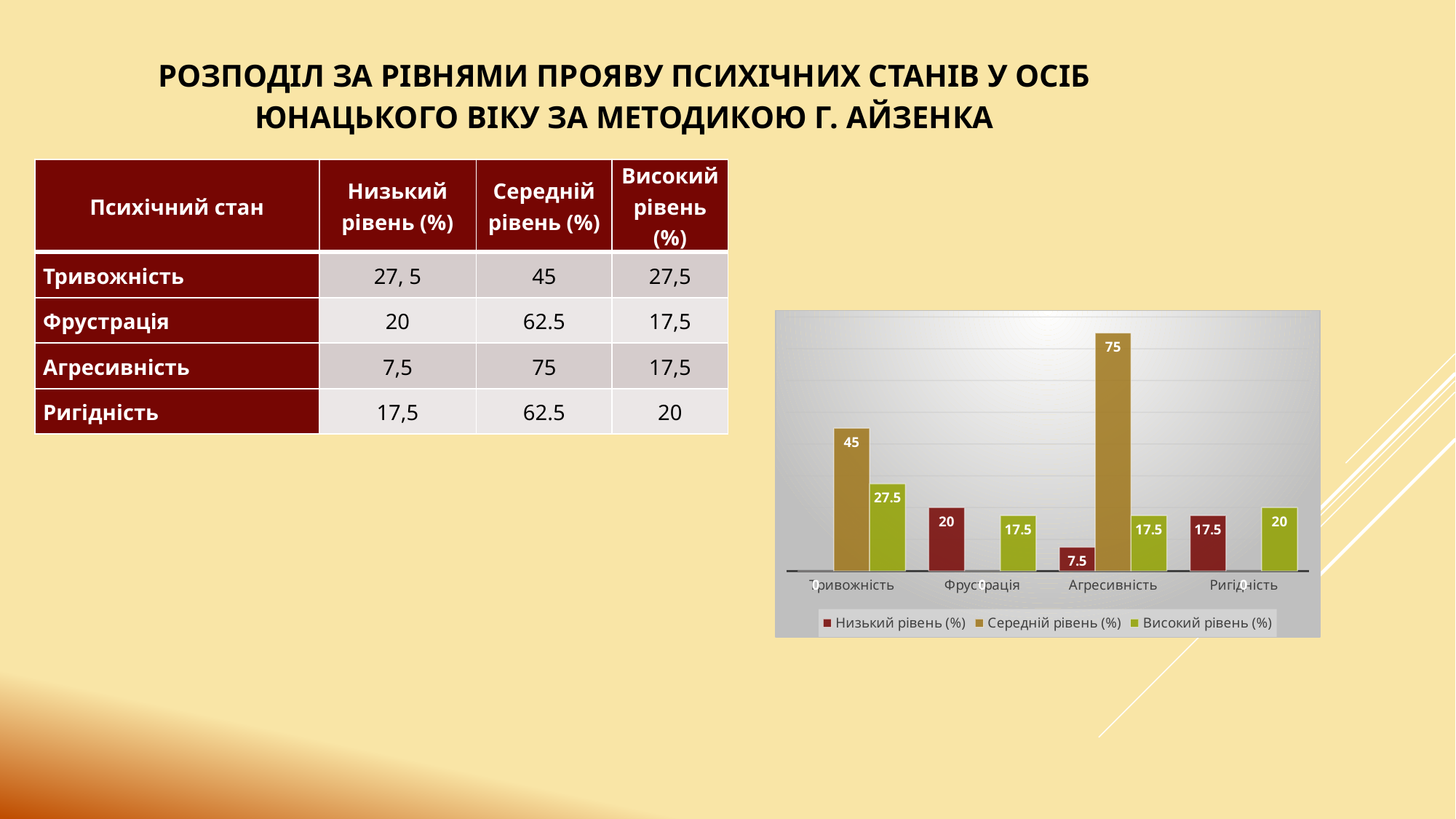
What is the value of Високий рівень (%) for Тривожність in the chart? 27.5 How many series does the chart legend list? 3 What colour represents Високий рівень (%) in the chart legend? green What is the value of Низький рівень (%) for Агресивність in the chart? 7.5 What is the difference between Середній рівень (%) and Низький рівень (%) for Агресивність in the chart? 67.5 What is the difference between Середній рівень (%) and Високий рівень (%) for Тривожність in the chart? 17.5 What is the value of Низький рівень (%) for Фрустрація in the chart? 20 Which is larger in the chart: Високий рівень (%) for Ригідність or Високий рівень (%) for Агресивність? Ригідність What kind of chart is shown on the slide? bar chart How many categories are shown along the x axis of the chart? 4 Which category has the tallest bar in the chart? Агресивність What is the value of Середній рівень (%) for Агресивність in the chart? 75